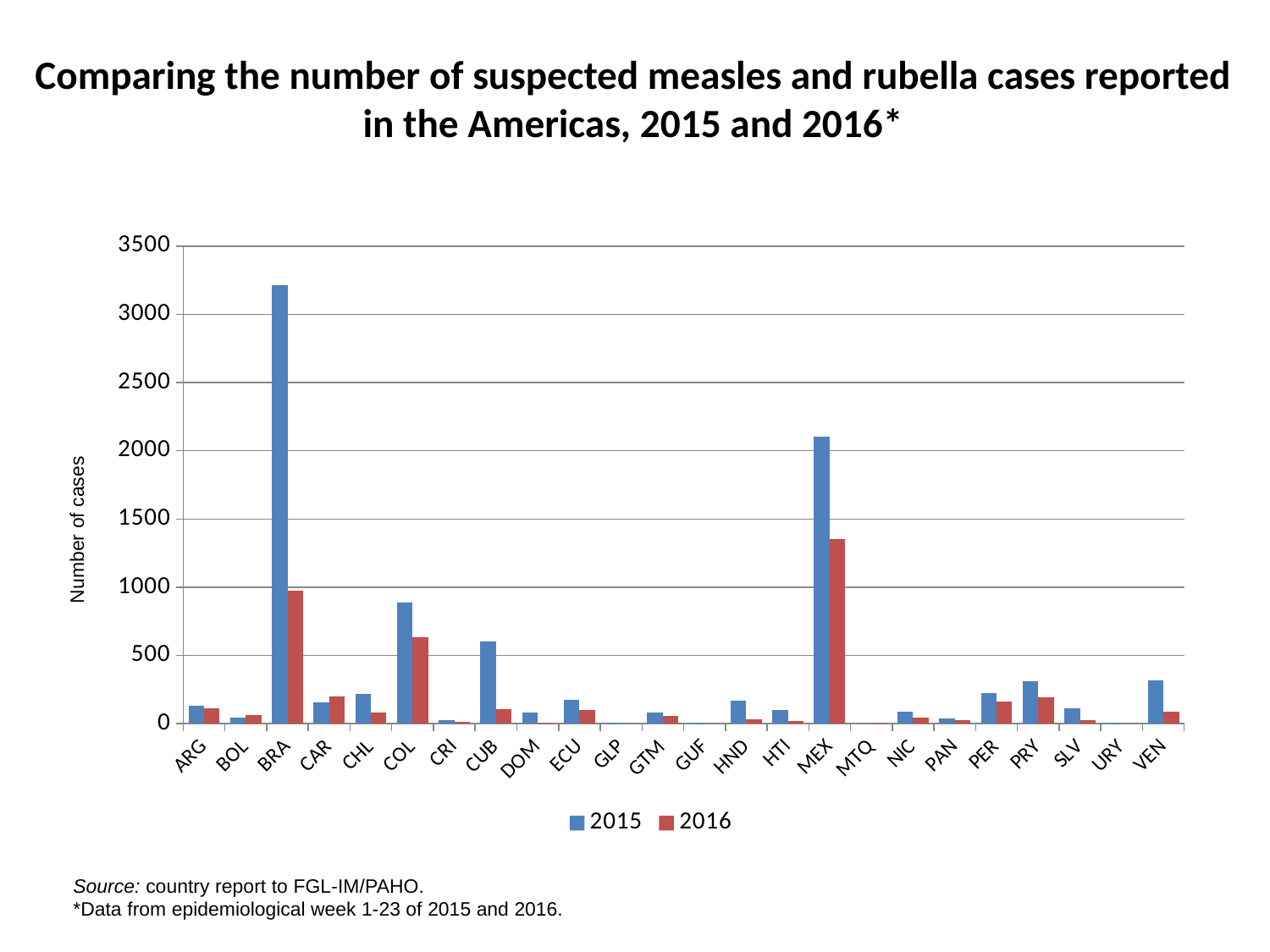
How many series does the legend list? 2 What is the label on the vertical axis? Number of cases Is the 2015 value for MEX greater or less than 2000? greater Which country has the highest number of suspected cases in 2015? BRA Is the 2015 value for BRA greater or less than 3000? greater Is the 2016 value for MEX greater or less than 1000? greater Which is larger for MEX, the 2015 value or the 2016 value? 2015 How many countries/territories are shown along the x axis? 24 Which country has the highest number of suspected cases in 2016? MEX What kind of chart is shown on the slide? bar chart Which country has the larger 2015 value, COL or CUB? COL